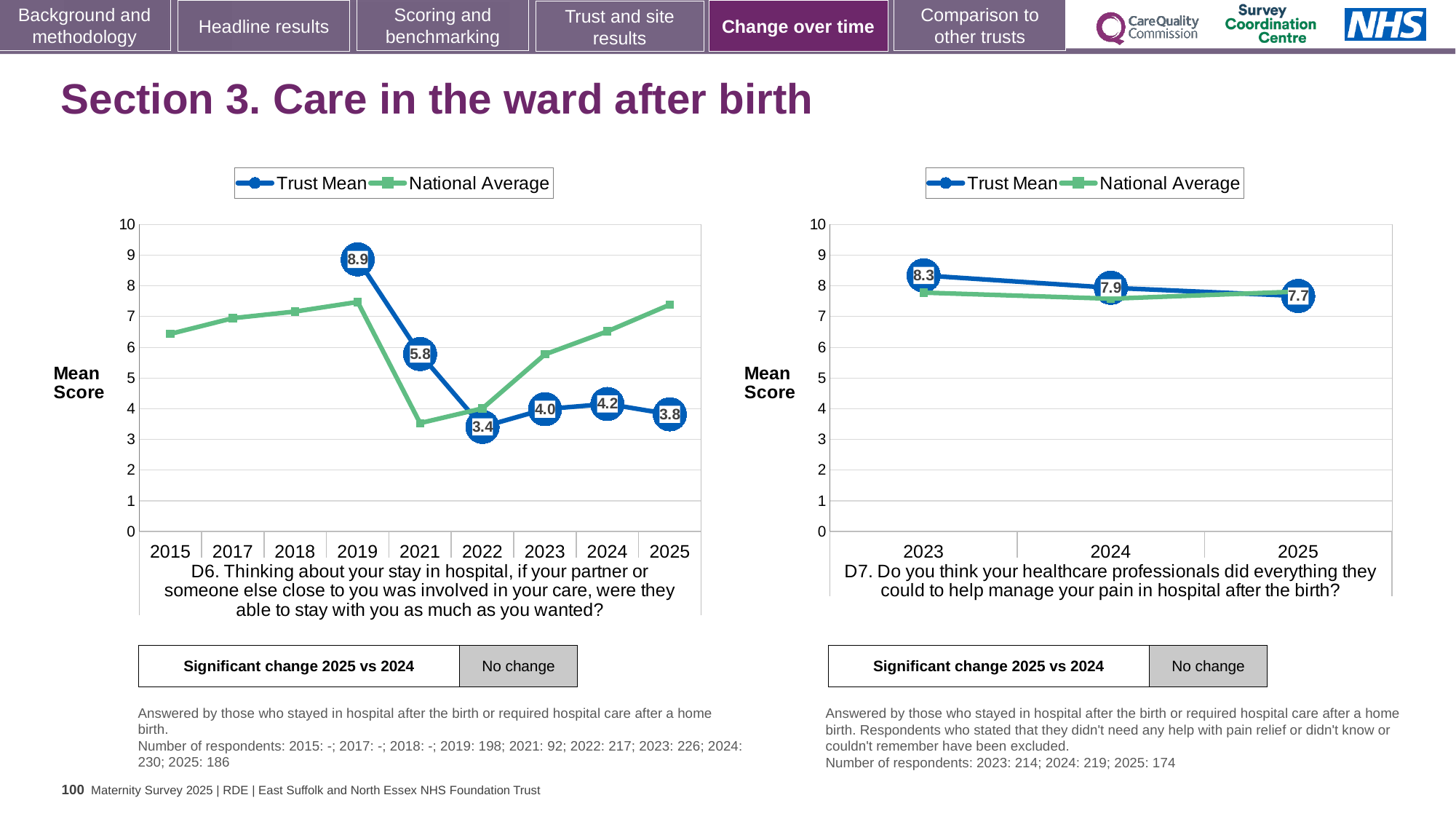
In the D6 chart on the left, what is the Trust Mean score for 2019? 8.9 What type of chart is the D6 chart on the left? line chart How many years are shown on the x axis of the D7 chart on the right? 3 In the D7 chart on the right, what is the Trust Mean score for 2024? 7.9 In the D6 chart on the left, which year has the highest Trust Mean score? 2019 In the D7 chart on the right, what is the difference between the Trust Mean scores for 2023 and 2025? 0.6 In the D6 chart on the left, which year has the lowest Trust Mean score? 2022 In the D6 chart on the left, what is the difference between the Trust Mean scores for 2019 and 2021? 3.1 In the D7 chart on the right, does the Trust Mean rise or fall from 2023 to 2025? fall In the D6 chart on the left, what is the Trust Mean score for 2022? 3.4 In the D6 chart on the left, what is the Trust Mean score for 2025? 3.8 In the D6 chart on the left, is the National Average for 2025 greater or less than 7? greater